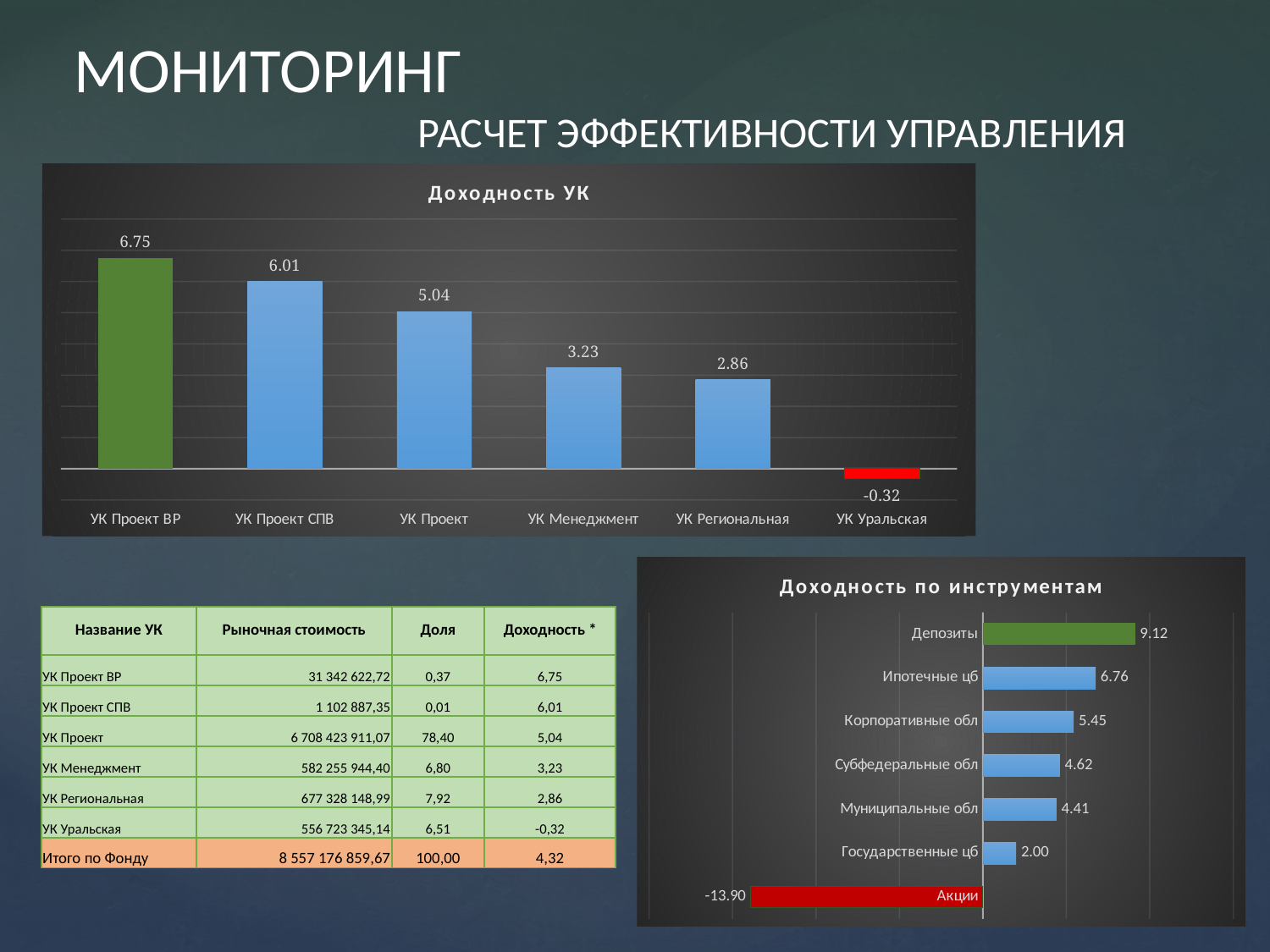
In the "Доходность УК" chart, what is the difference between the values for УК Проект ВР and УК Проект СПВ? 0.74 In the "Доходность УК" chart, which category has the lowest value? УК Уральская In the "Доходность УК" chart, how many categories are plotted? 6 In the "Доходность УК" chart, which category has the highest value? УК Проект ВР In the "Доходность по инструментам" chart, which category has the lowest value? Акции In the "Доходность по инструментам" chart, what is the value for Муниципальные обл? 4.41 In the "Доходность УК" chart, do the values rise or fall from left to right along the x axis? fall In the "Доходность по инструментам" chart, which is larger: the value for Ипотечные цб or the value for Корпоративные обл? Ипотечные цб In the "Доходность по инструментам" chart, which category has the highest value? Депозиты In the "Доходность УК" chart, what is the value for УК Проект? 5.04 In the "Доходность УК" chart, what is the value for УК Уральская? -0.32 What kind of chart is "Доходность по инструментам"? bar chart